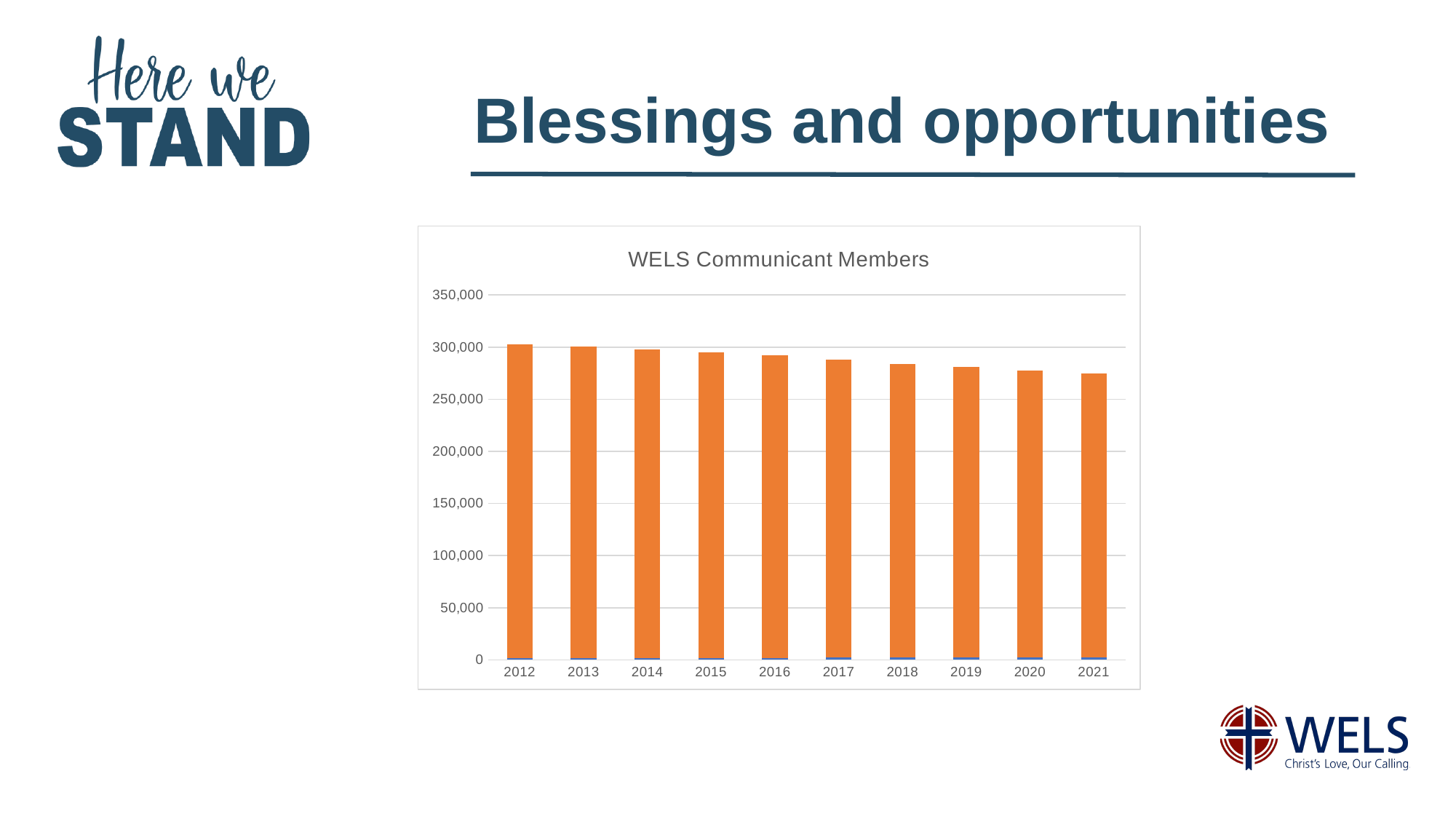
What colour are the bars in the chart? orange Do the values rise or fall from 2012 to 2021? fall What kind of chart is shown on the slide? bar chart Which year has the highest number of communicant members? 2012 What is the title of the chart? WELS Communicant Members How many years are shown on the x axis of the chart? 10 Which is larger, the value for 2012 or the value for 2021? 2012 Which is larger, the value for 2020 or the value for 2013? 2013 Is the value for 2021 greater or less than 250,000? greater Is the value for 2021 greater or less than 300,000? less Which year has the lowest number of communicant members? 2021 Is the value for 2017 greater or less than 250,000? greater